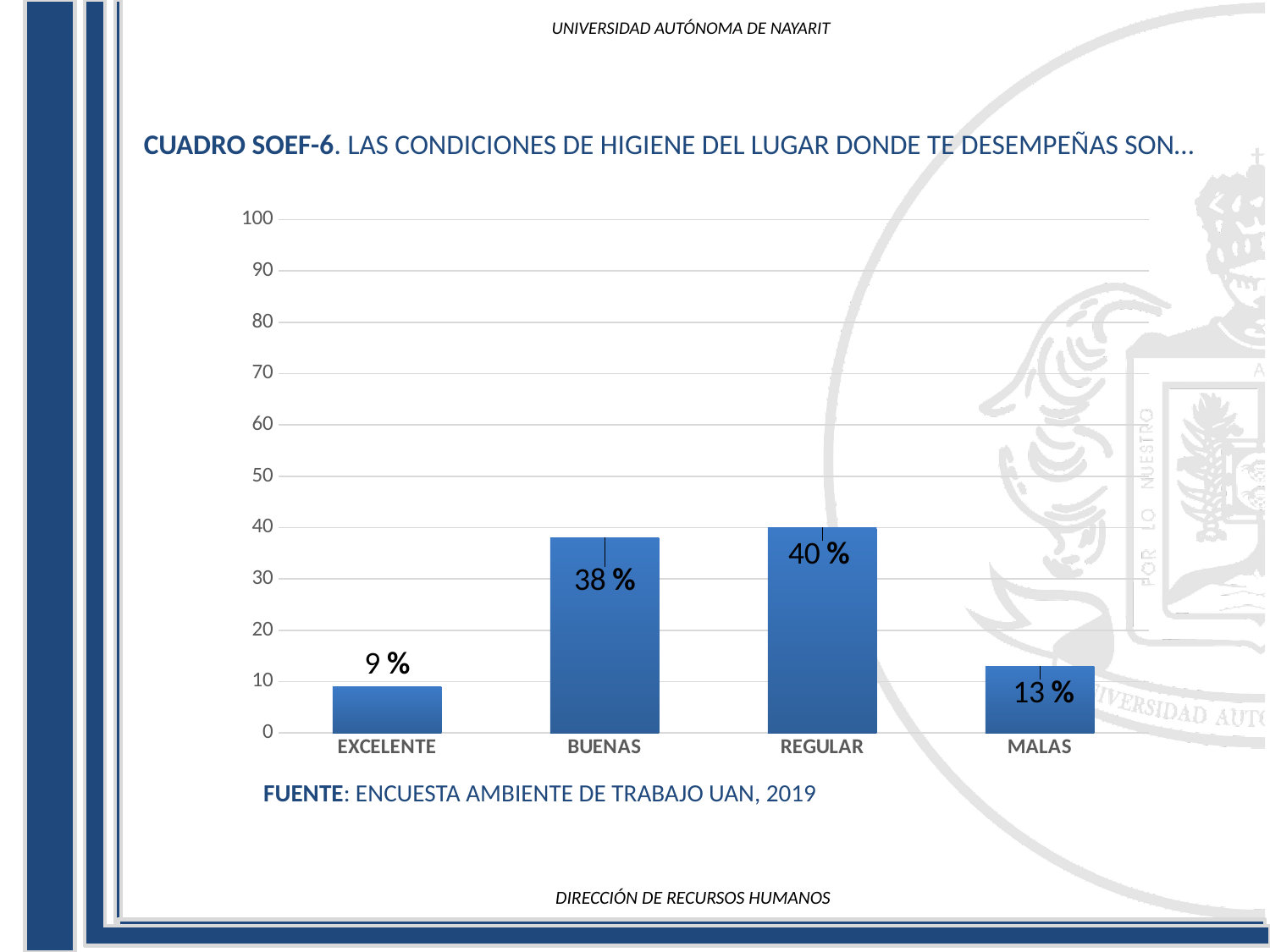
What is the value for MALAS? 13 % Which category has the lowest value? EXCELENTE How many categories are shown on the x axis? 4 Which category has the highest value? REGULAR What is the value for EXCELENTE? 9 % What is the value for REGULAR? 40 % What is the difference between the values for REGULAR and EXCELENTE? 31 % What kind of chart is shown on the slide? bar chart Which is larger, the value for BUENAS or the value for MALAS? BUENAS What is the value for BUENAS? 38 % Is the value for MALAS greater or less than 20? less What is the source cited below the chart? ENCUESTA AMBIENTE DE TRABAJO UAN, 2019